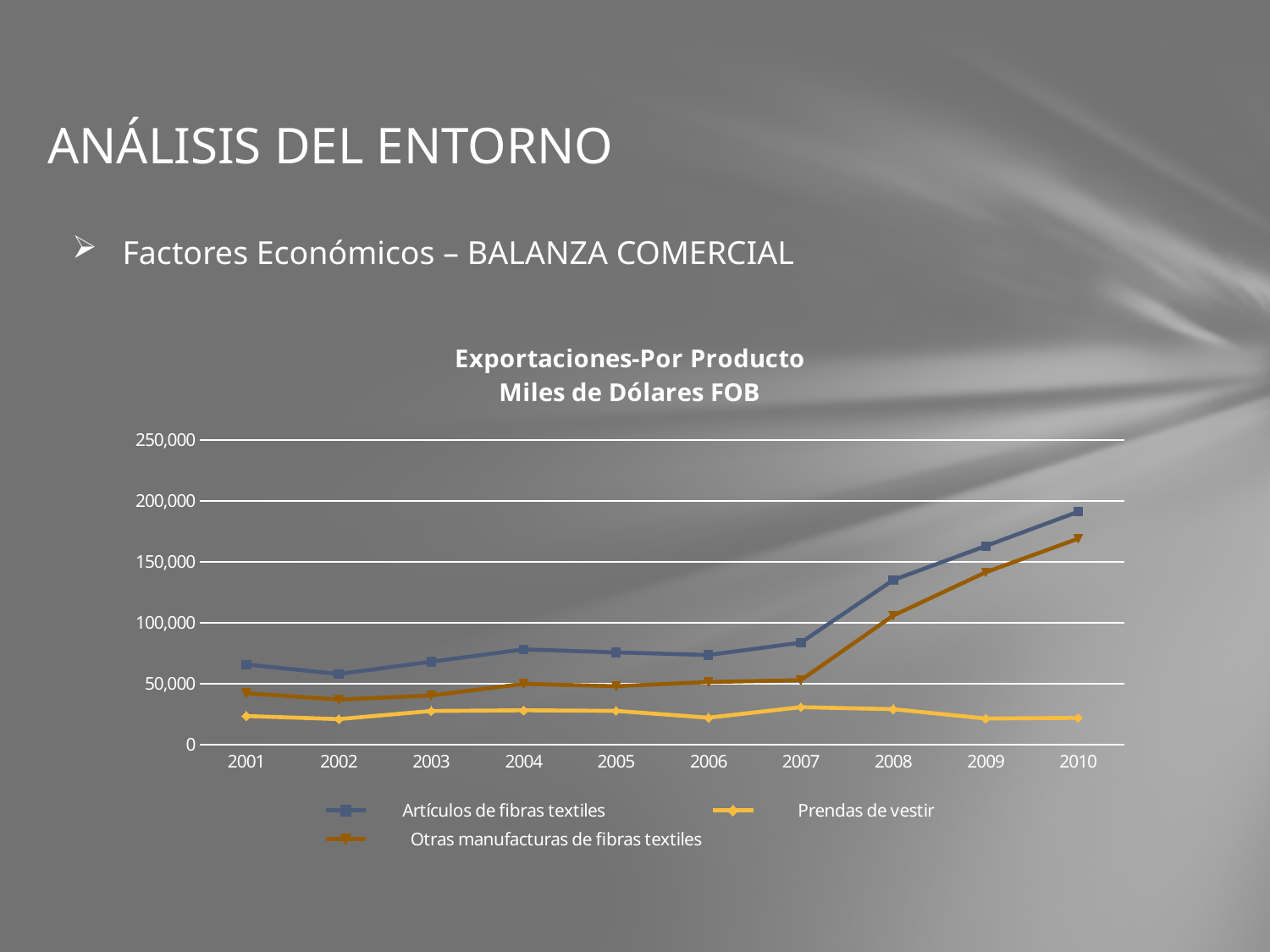
Is the value for Prendas de vestir in 2007 greater or less than 50,000? less What kind of chart is shown on the slide? Line chart Which series is lowest in 2010? Prendas de vestir How many years are shown on the x axis? 10 Is the value for Otras manufacturas de fibras textiles in 2010 greater or less than 150,000? greater Is the value for Artículos de fibras textiles in 2010 greater or less than 200,000? less How many series does the legend list? 3 In which year is the value for Artículos de fibras textiles highest? 2010 What is the title of the chart? Exportaciones-Por Producto Miles de Dólares FOB Does the value for Artículos de fibras textiles rise or fall from 2007 to 2010? Rise Which series is highest in 2010? Artículos de fibras textiles In which year is the value for Artículos de fibras textiles lowest? 2002